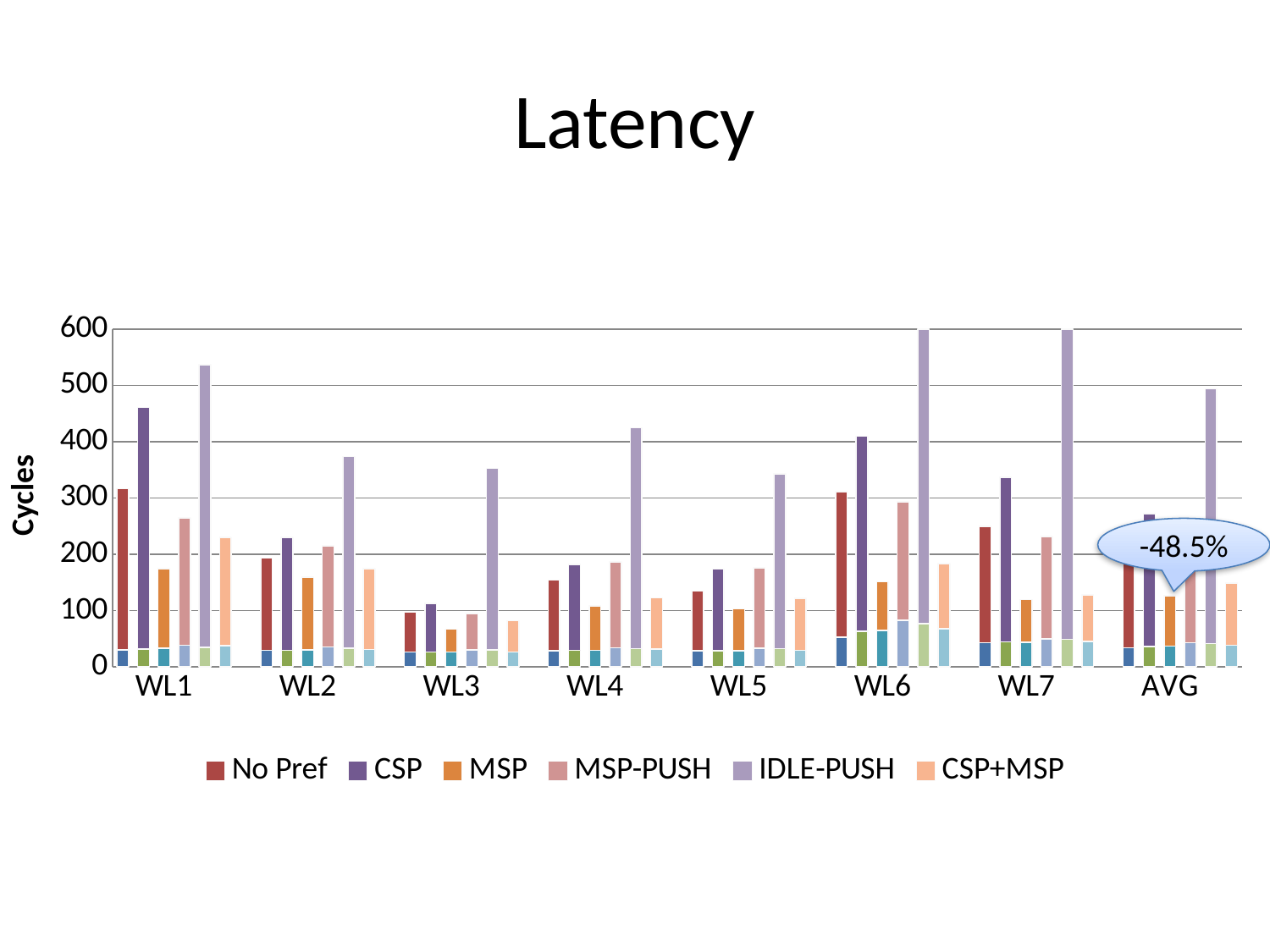
Which workload has the lowest No Pref bar? WL3 Which is larger, the No Pref value for WL1 or the No Pref value for WL2? WL1 What is the label on the y axis of the Latency chart? Cycles How many categories are shown along the x axis of the Latency chart? 8 Is the CSP value for WL1 greater or less than 400? greater What type of chart is shown on the slide? bar chart Is the CSP+MSP value for WL3 greater or less than 100? less How many series does the legend of the Latency chart list? 6 For WL1, which series has the shortest bar? MSP What percentage is shown in the callout near the AVG bars? -48.5% For WL1, which series has the tallest bar? IDLE-PUSH Is the IDLE-PUSH value for WL1 greater or less than 500? greater